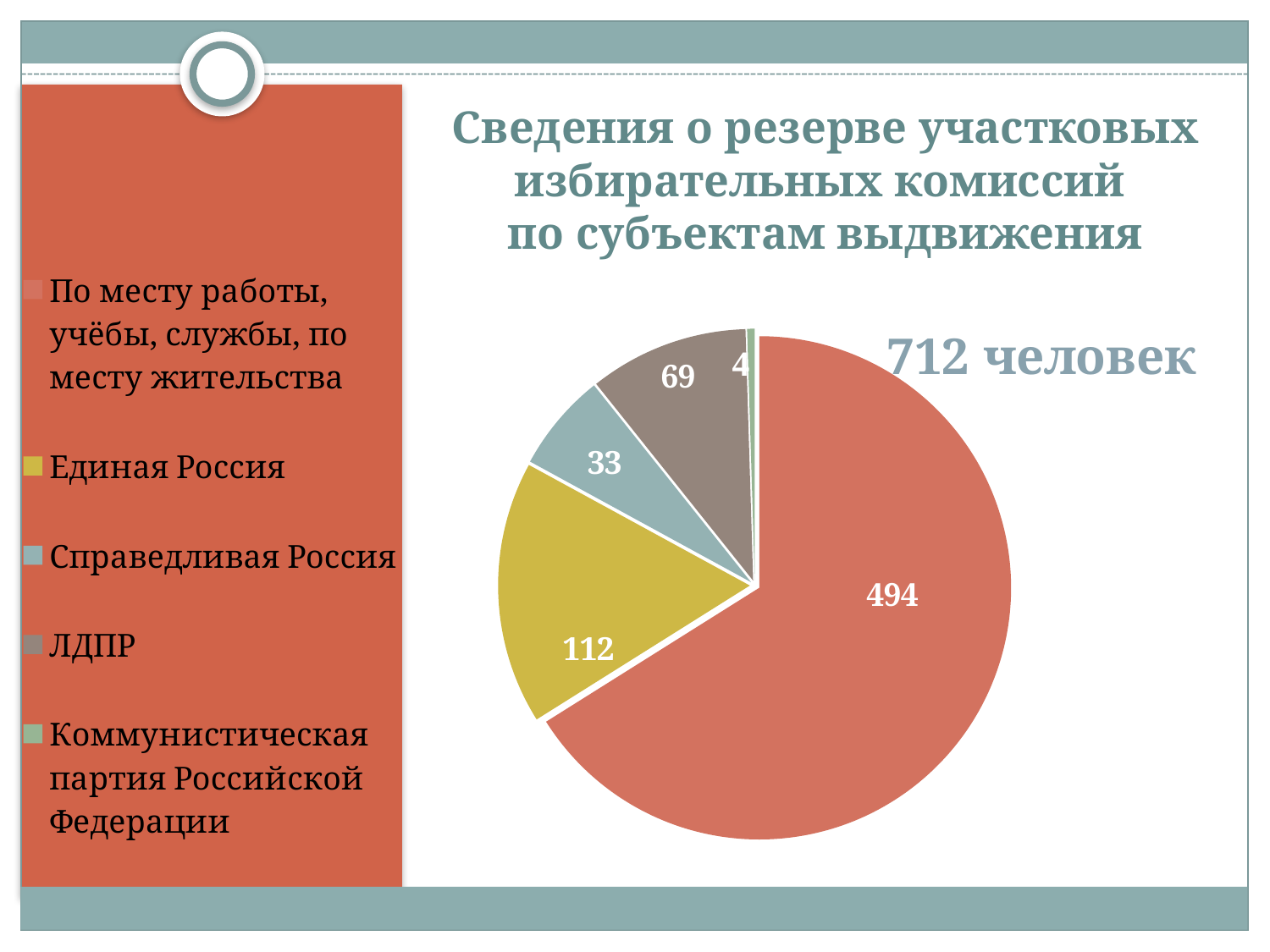
What type of chart is shown on the slide? Pie chart How many slices does the pie chart have? 5 Which category has the smallest slice? Коммунистическая партия Российской Федерации What is the difference between the values for Единая Россия and ЛДПР? 43 What is the total number of people shown on the slide? 712 человек What is the value for Справедливая Россия? 33 Which is larger, the value for ЛДПР or the value for Справедливая Россия? ЛДПР Which category has the largest slice? По месту работы, учёбы, службы, по месту жительства What is the value for Коммунистическая партия Российской Федерации? 4 What is the value for ЛДПР? 69 What share of the pie does the slice for Единая Россия represent? 15.7% What is the value for Единая Россия? 112